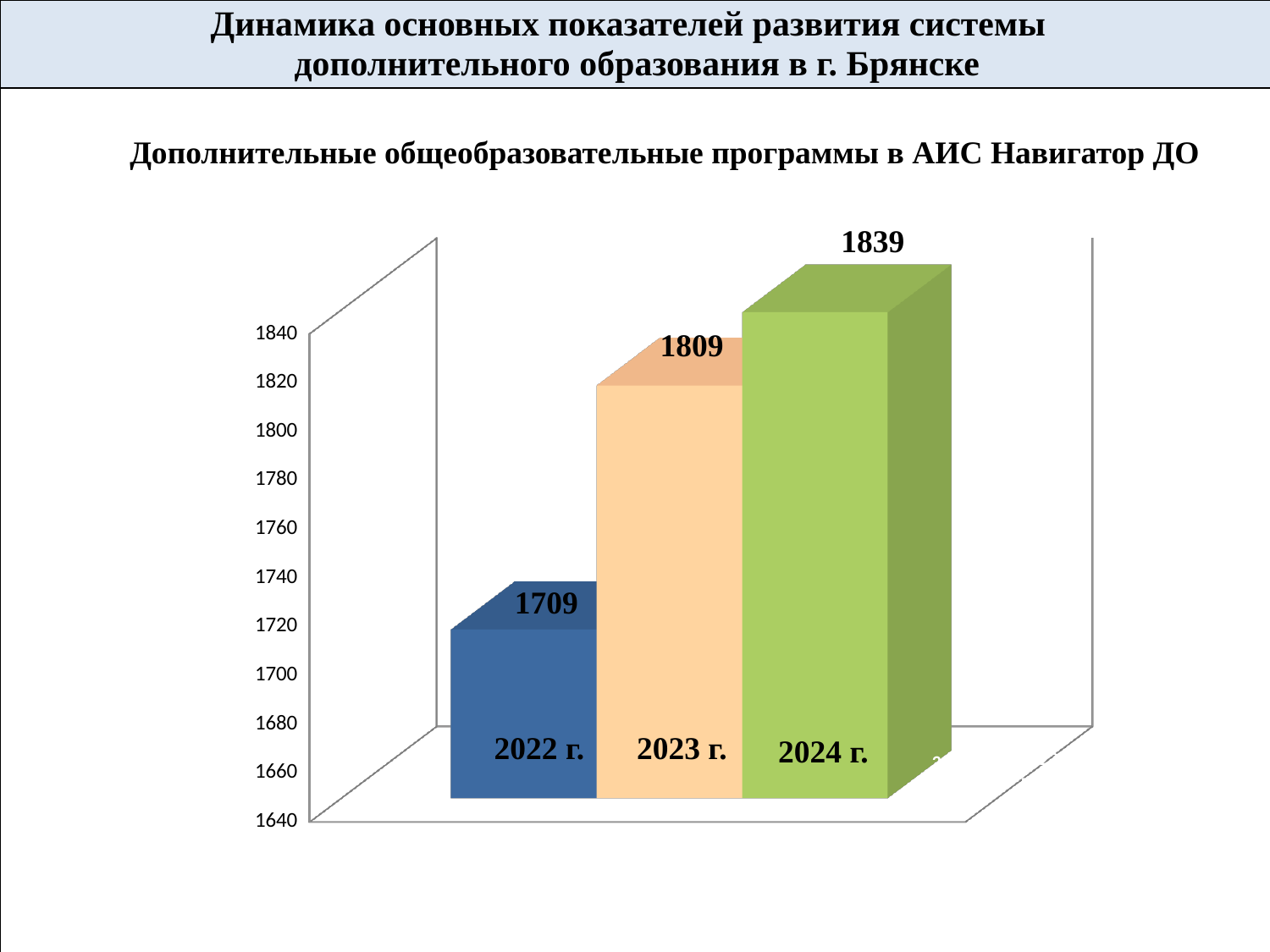
What is the difference between the values for 2024 г. and 2022 г.? 130 Do the values rise or fall from 2022 г. to 2024 г.? rise What is the value for 2023 г.? 1809 What is the title of the chart? Дополнительные общеобразовательные программы в АИС Навигатор ДО Which year has the highest value? 2024 г. Which year has the lowest value? 2022 г. What kind of chart is shown on the slide? bar chart What is the value for 2024 г.? 1839 What is the value for 2022 г.? 1709 How many years are shown in the chart? 3 Which is larger, the value for 2023 г. or the value for 2024 г.? 2024 г. What is the difference between the values for 2023 г. and 2022 г.? 100